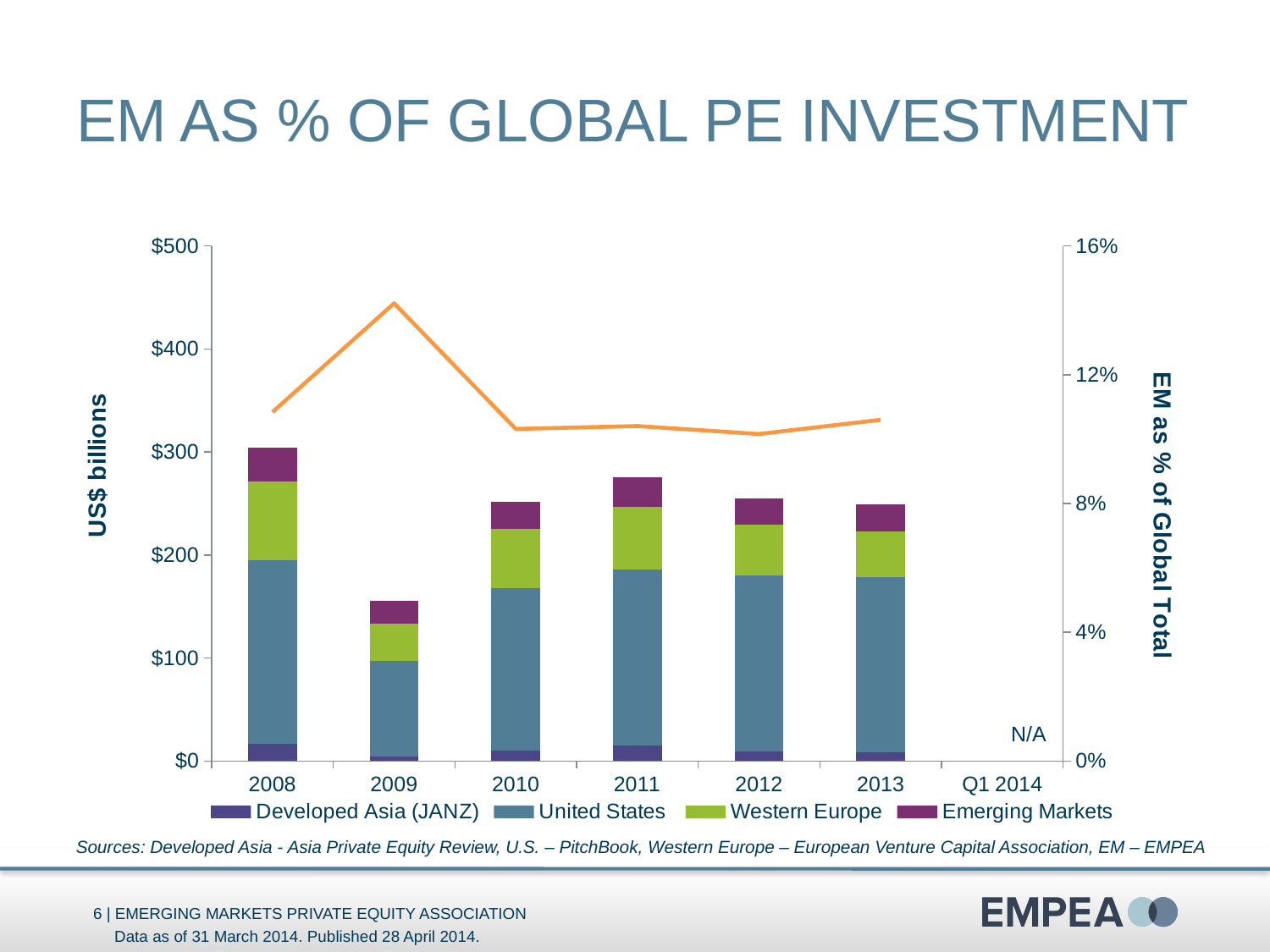
How many series does the legend list? 4 What kind of chart is shown on the slide? Stacked bar chart with a line Does the EM as % of Global Total line rise or fall from 2009 to 2012? fall Is the EM as % of Global Total line value for 2012 greater or less than 12%? less Which stacked bar is taller, 2008 or 2009? 2008 What label is shown in place of a bar for Q1 2014? N/A Is the total stacked bar for 2008 greater or less than $200? greater Which year has the tallest stacked bar? 2008 Which year has the shortest stacked bar? 2009 Is the EM as % of Global Total line value for 2009 greater or less than 12%? greater How many categories are shown on the x axis? 7